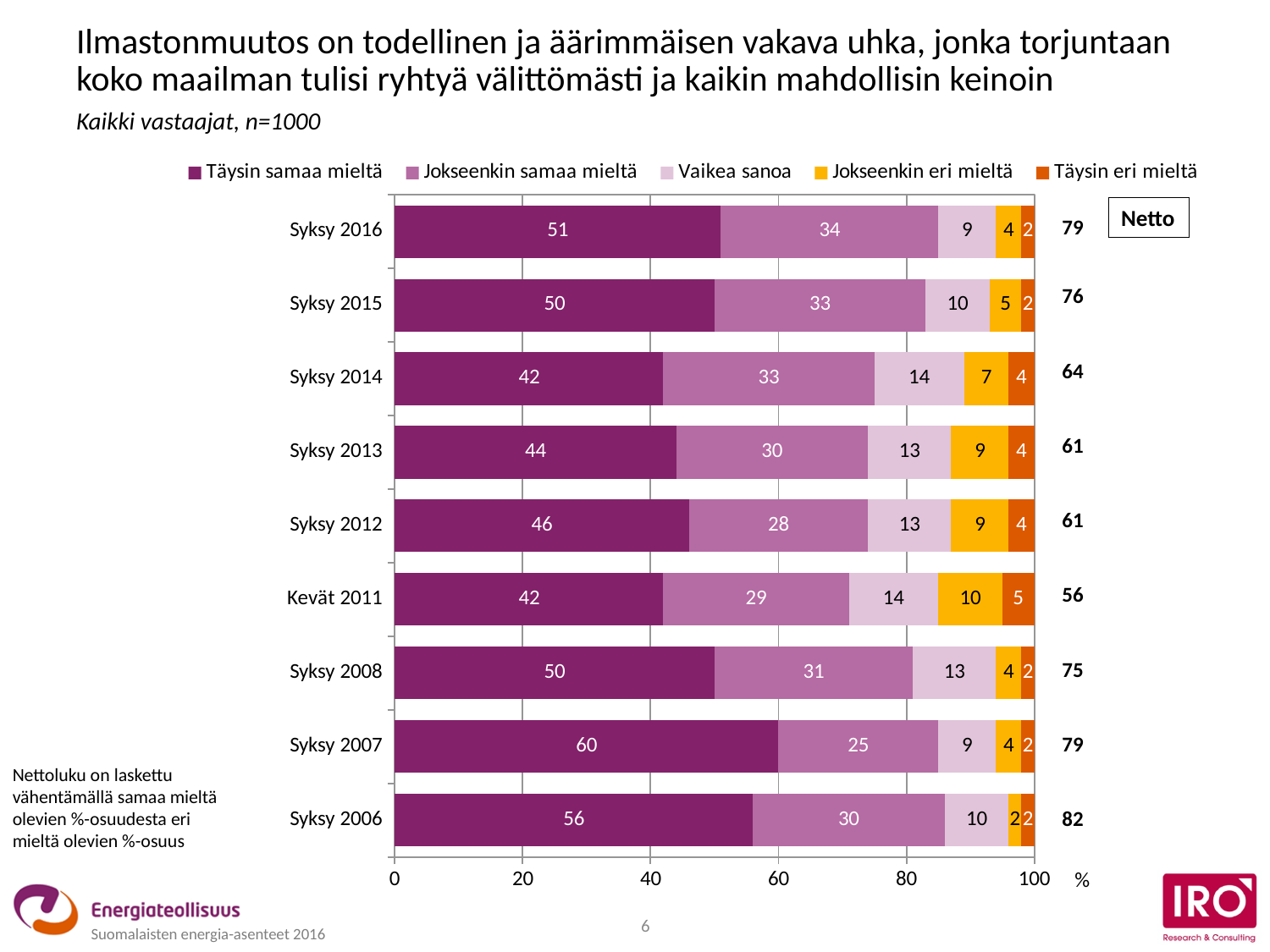
What is the total of the stacked bar for Syksy 2016? 100 Which category has the highest value for "Täysin samaa mieltä"? Syksy 2007 What is the value for "Täysin samaa mieltä" for Syksy 2016? 51 What is the Netto value shown for Syksy 2006? 82 How many categories (survey rounds) are shown on the chart? 9 How many series does the legend list? 5 Which category has the lowest Netto value? Kevät 2011 What is the difference between the "Täysin samaa mieltä" values for Syksy 2007 and Syksy 2006? 4 What is the value for "Vaikea sanoa" for Kevät 2011? 14 What is the value for "Jokseenkin samaa mieltä" for Syksy 2014? 33 Which is larger, the "Jokseenkin samaa mieltä" value for Syksy 2016 or for Syksy 2012? Syksy 2016 What kind of chart is shown on the slide? Stacked bar chart